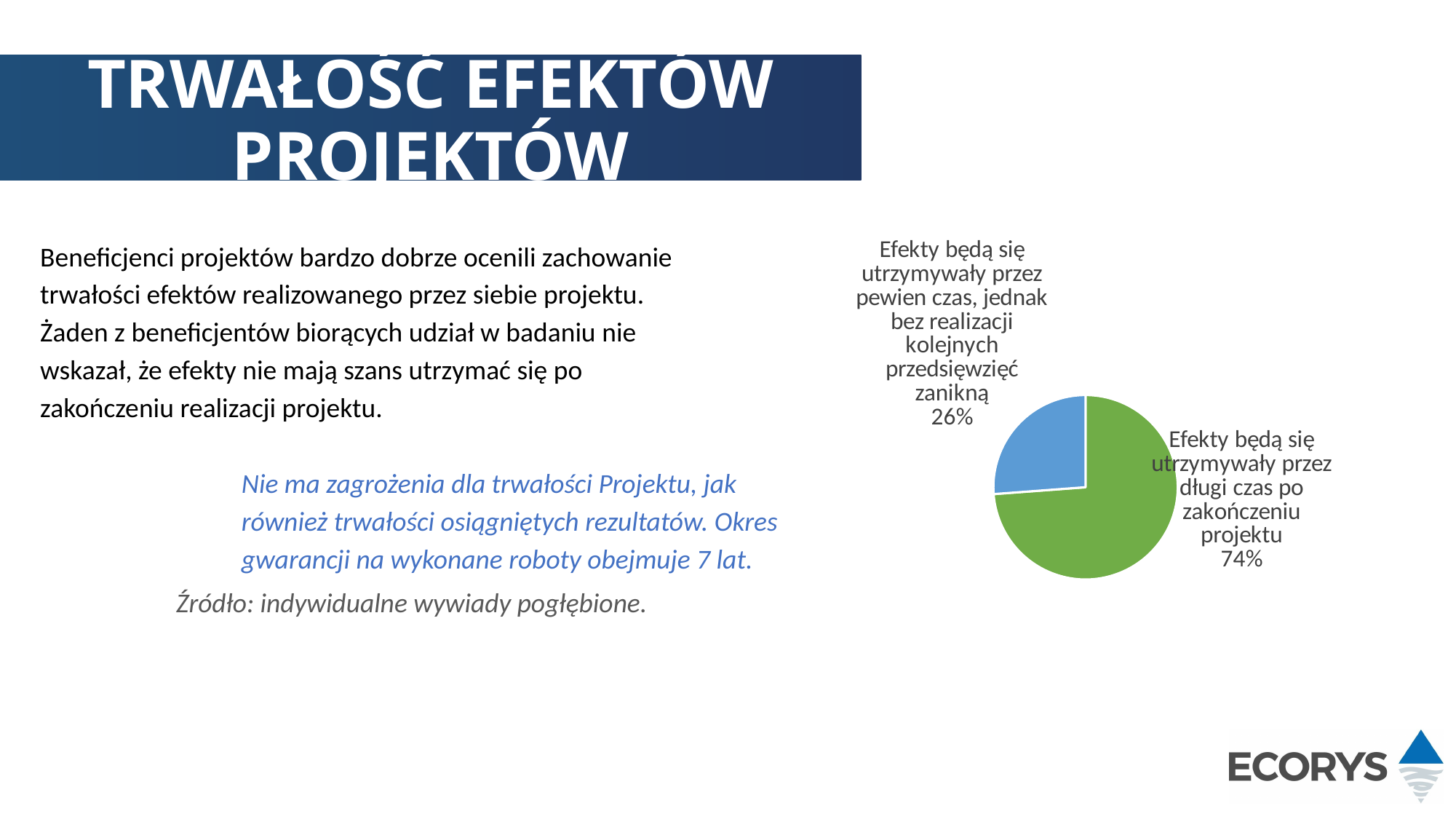
How many slices does the pie chart have? 2 Which slice of the pie chart is the largest? Efekty będą się utrzymywały przez długi czas po zakończeniu projektu Which slice of the pie chart is the smallest? Efekty będą się utrzymywały przez pewien czas, jednak bez realizacji kolejnych przedsięwzięć zanikną What share of the pie is labelled "Efekty będą się utrzymywały przez długi czas po zakończeniu projektu"? 74% What colour is the slice representing 26% in the pie chart? blue What is the difference in percentage points between the two slices of the pie chart? 48 Is the slice for "Efekty będą się utrzymywały przez długi czas po zakończeniu projektu" larger or smaller than the slice for "Efekty będą się utrzymywały przez pewien czas, jednak bez realizacji kolejnych przedsięwzięć zanikną"? larger What colour is the slice representing 74% in the pie chart? green Is the share for "Efekty będą się utrzymywały przez pewien czas, jednak bez realizacji kolejnych przedsięwzięć zanikną" greater or less than 50%? less What kind of chart is shown on the slide? pie chart What share of the pie is labelled "Efekty będą się utrzymywały przez pewien czas, jednak bez realizacji kolejnych przedsięwzięć zanikną"? 26%